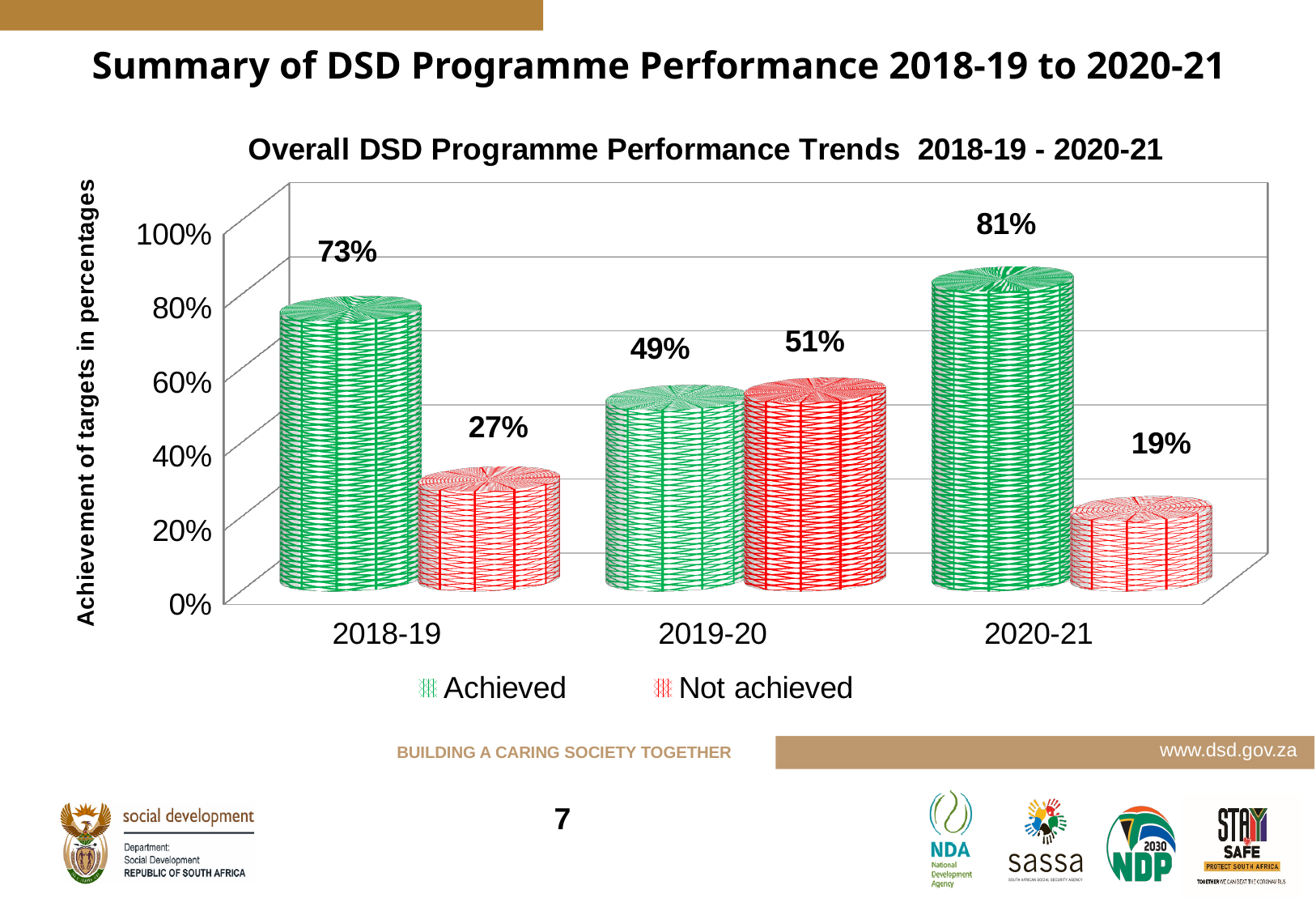
What is the difference between the 'Achieved' values for 2020-21 and 2018-19? 8% How many series does the legend list? 2 How many years are shown on the x axis? 3 What percentage of targets was achieved in 2018-19? 73% What is the title of the chart? Overall DSD Programme Performance Trends 2018-19 - 2020-21 What is the 'Not achieved' value for 2019-20? 51% In 2019-20, which is larger: 'Achieved' or 'Not achieved'? Not achieved Which year has the lowest 'Not achieved' value? 2020-21 What kind of chart is shown on the slide? Bar chart Which year has the highest 'Achieved' value? 2020-21 What is the label of the vertical axis? Achievement of targets in percentages What is the 'Achieved' value for 2020-21? 81%